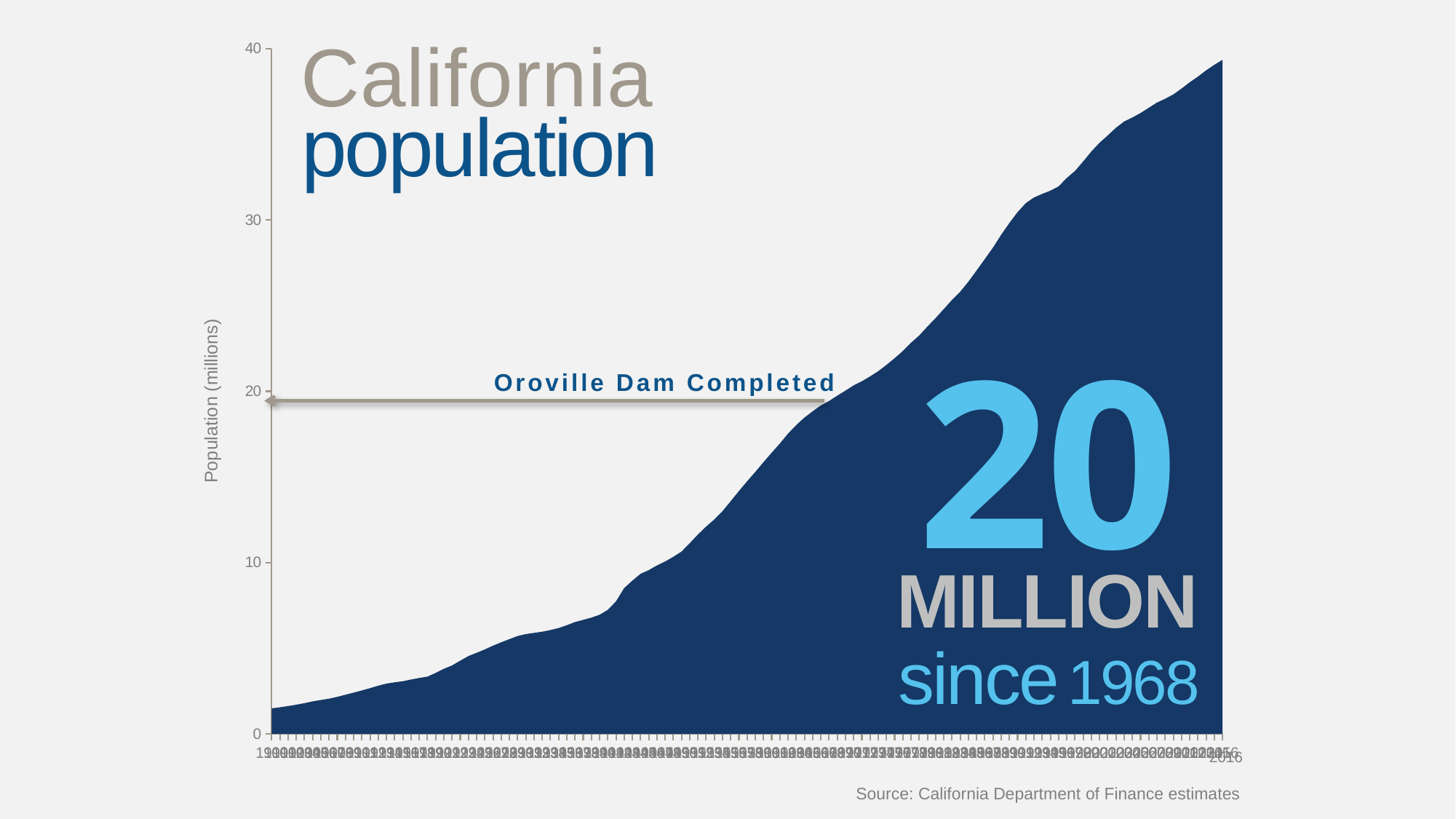
Does California's population rise or fall over time along the x axis? Rise What kind of chart is shown on the slide? Area chart Is the population value at the start of the chart (left end) greater or less than 10 million? less According to the text on the chart, by how much has California's population grown since 1968? 20 million What is the highest tick value shown on the y axis? 40 What is the source cited for the chart data? California Department of Finance estimates What is the last year labelled on the x axis? 2016 What is the label of the y axis? Population (millions) Is the population value at the point marked 'Oroville Dam Completed' greater or less than 30 million? less Is the population value at the point marked 'Oroville Dam Completed' greater or less than 10 million? greater What event is annotated on the chart with an arrow? Oroville Dam Completed